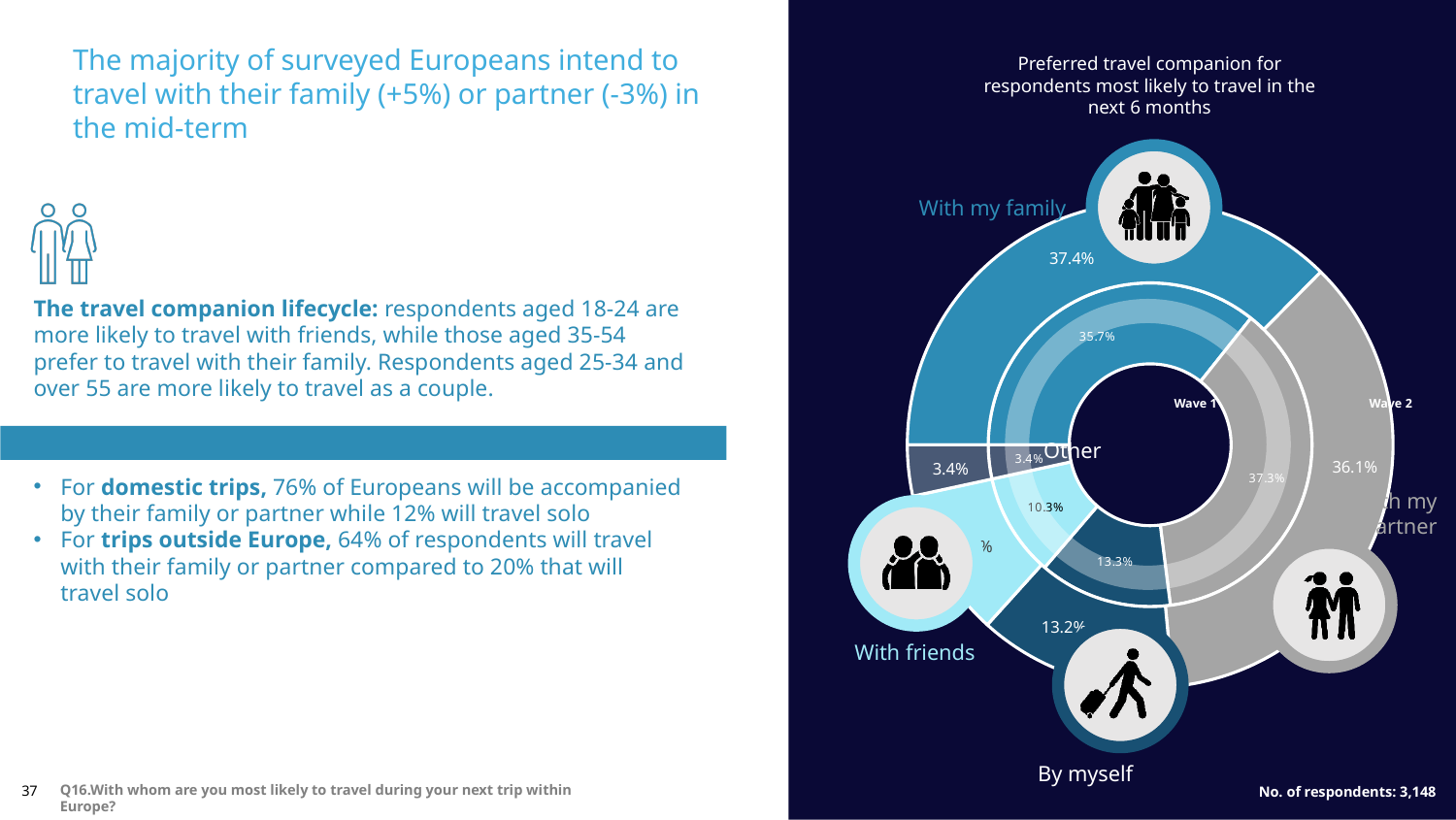
In Wave 1, which is larger: the share for 'With my family' or 'With my partner'? With my partner What share of Wave 1 respondents prefer to travel with friends? 10.3% Which travel companion category has the lowest share in Wave 2? Other What share of Wave 2 respondents prefer to travel with their family? 37.4% What share of Wave 1 respondents prefer to travel with their family? 35.7% Which travel companion category has the highest share in Wave 2? With my family What type of chart is used to show the preferred travel companion? Doughnut (pie) chart What share of Wave 2 respondents prefer to travel by themselves? 13.2% How many waves (series) does the chart show? 2 How many travel companion categories are shown in the chart? 5 What share of Wave 2 respondents prefer to travel with their partner? 36.1% In Wave 2, how much larger is the share for 'With my family' than for 'With my partner'? 1.3%